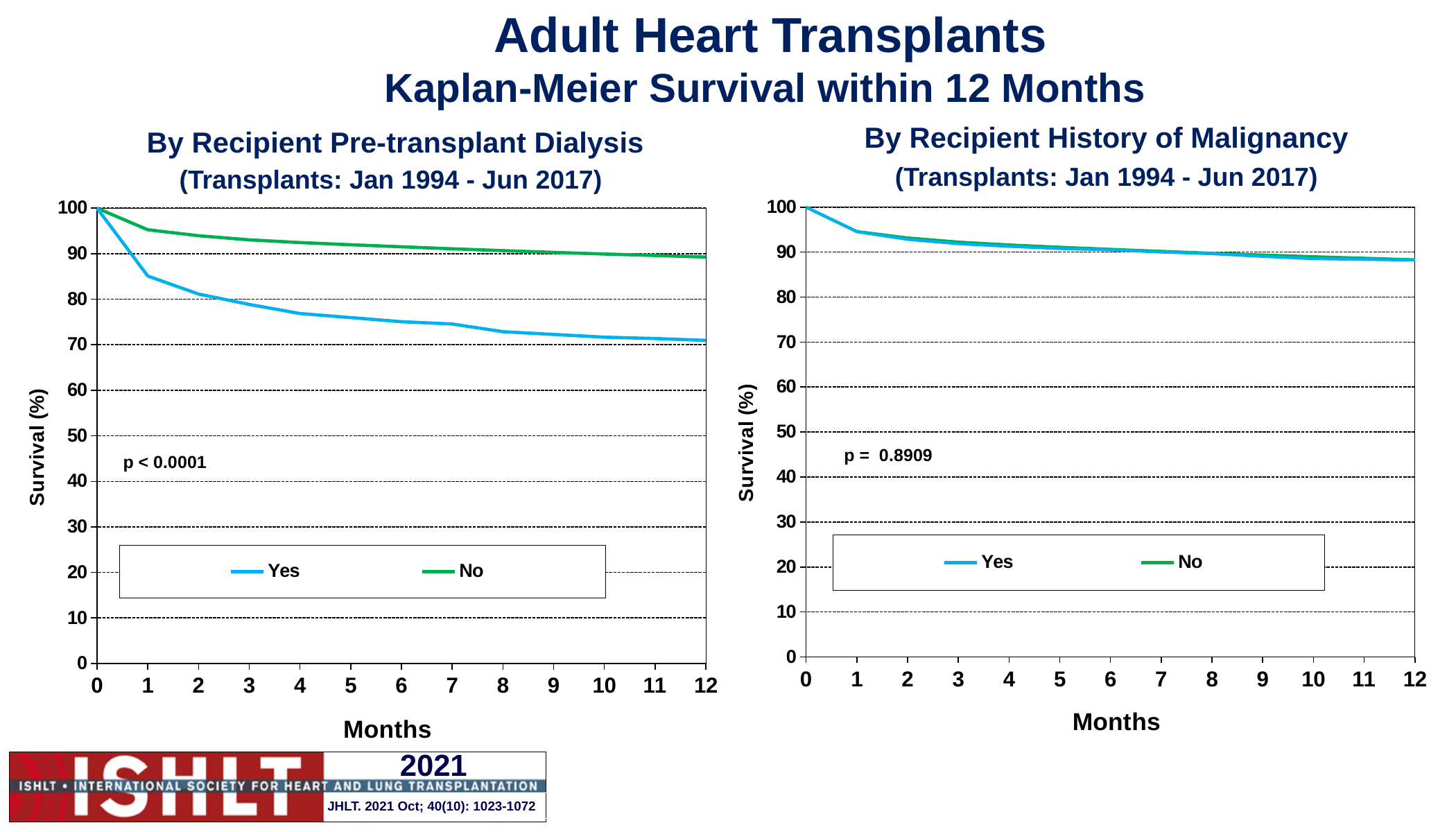
In the chart titled 'By Recipient History of Malignancy', is the survival value for 'Yes' at 12 months greater or less than 80? greater In the chart titled 'By Recipient Pre-transplant Dialysis', is the survival value for 'Yes' at 12 months greater or less than 80? less In the chart titled 'By Recipient Pre-transplant Dialysis', what kind of chart is shown? line chart In the chart titled 'By Recipient Pre-transplant Dialysis', which series has the higher survival at 12 months, 'Yes' or 'No'? No In the chart titled 'By Recipient History of Malignancy', how many series does the legend list? 2 In the chart titled 'By Recipient History of Malignancy', how many month tick marks are labelled on the x axis? 13 In the chart titled 'By Recipient Pre-transplant Dialysis', does the 'Yes' survival curve rise or fall as months increase? fall In the chart titled 'By Recipient History of Malignancy', is the survival value for 'No' at 1 month greater or less than 90? greater In the chart titled 'By Recipient Pre-transplant Dialysis', what are the two legend entries? Yes and No In the chart titled 'By Recipient Pre-transplant Dialysis', what p-value is printed on the chart? p < 0.0001 In the chart titled 'By Recipient Pre-transplant Dialysis', what is the survival value for the 'Yes' series at month 0? 100